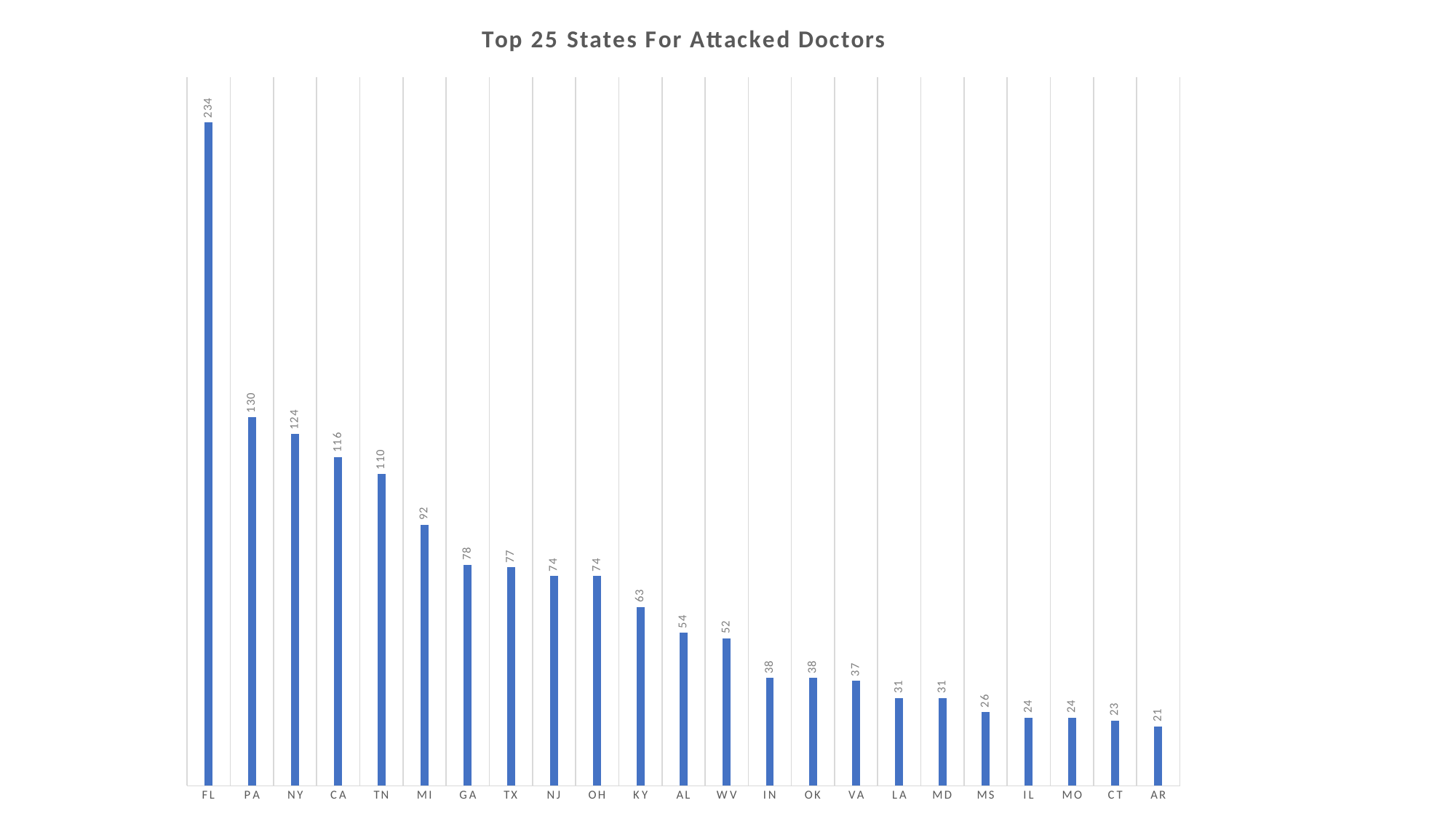
What is the difference between the values for FL and PA? 104 Which state has the highest value? FL What is the value for AR? 21 How many states are shown on the chart? 23 Which state has the lowest value? AR What kind of chart is shown on the slide? Bar chart What is the value for FL? 234 Do the values rise or fall from left to right along the x axis? Fall What is the difference between the values for MI and GA? 14 What is the value for KY? 63 Which is larger, the value for CA or the value for MI? CA What is the value for TN? 110